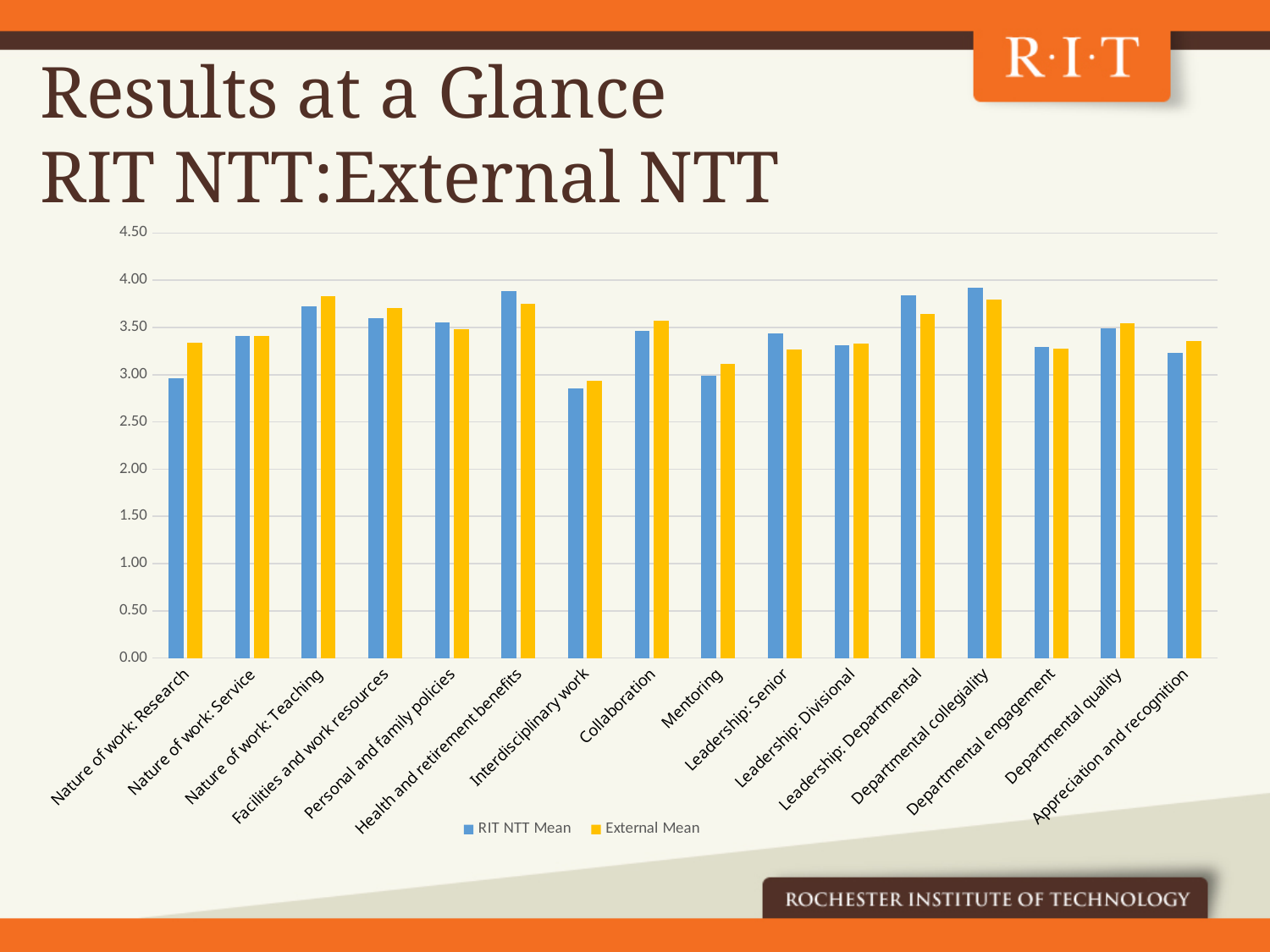
For Nature of work: Research, which is larger, the RIT NTT Mean or the External Mean? External Mean Is the External Mean for Mentoring greater or less than 3.00? greater For Leadership: Departmental, which is larger, the RIT NTT Mean or the External Mean? RIT NTT Mean How many categories are plotted along the x axis? 16 Which series is shown in blue in the legend? RIT NTT Mean Which category has the lowest RIT NTT Mean? Interdisciplinary work Is the RIT NTT Mean for Health and retirement benefits greater or less than 3.50? greater How many series does the legend list? 2 Is the RIT NTT Mean for Departmental collegiality greater or less than 4.00? less Which category has the lowest External Mean? Interdisciplinary work What kind of chart is shown on the slide? bar chart